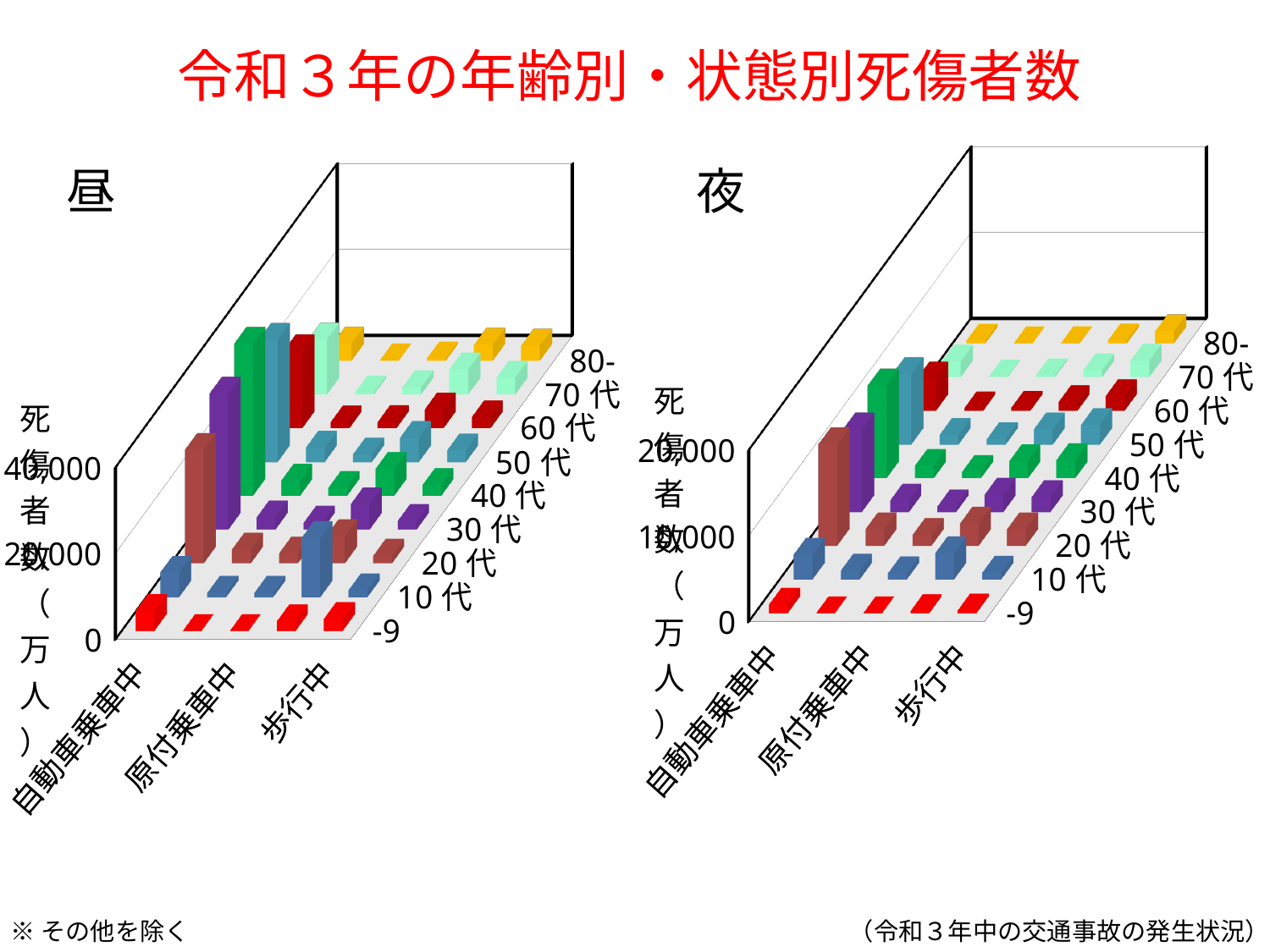
Which chart has the larger maximum value on its vertical axis, 昼 or 夜? 昼 In the 昼 chart, which age group is labeled at the front of the depth axis? -9 In the 昼 chart, which state category (自動車乗車中, 原付乗車中, 歩行中) has the tallest bars? 自動車乗車中 How many state categories are labeled on the horizontal axis of the 夜 chart? 3 What kind of chart is used on this slide for 昼 and 夜? bar chart What is the highest value shown on the vertical axis of the 夜 chart? 20,000 In the 夜 chart, which state category has the tallest bars? 自動車乗車中 In the 昼 chart, is the value for 自動車乗車中 in the -9 age group greater or less than 20,000? less What is the highest value shown on the vertical axis of the 昼 chart? 40,000 In the 昼 chart, is the value for 自動車乗車中 in the 10代 age group greater or less than 20,000? less In the 夜 chart, is the value for 自動車乗車中 in the -9 age group greater or less than 10,000? less How many age groups are shown along the depth axis of the 昼 chart? 9